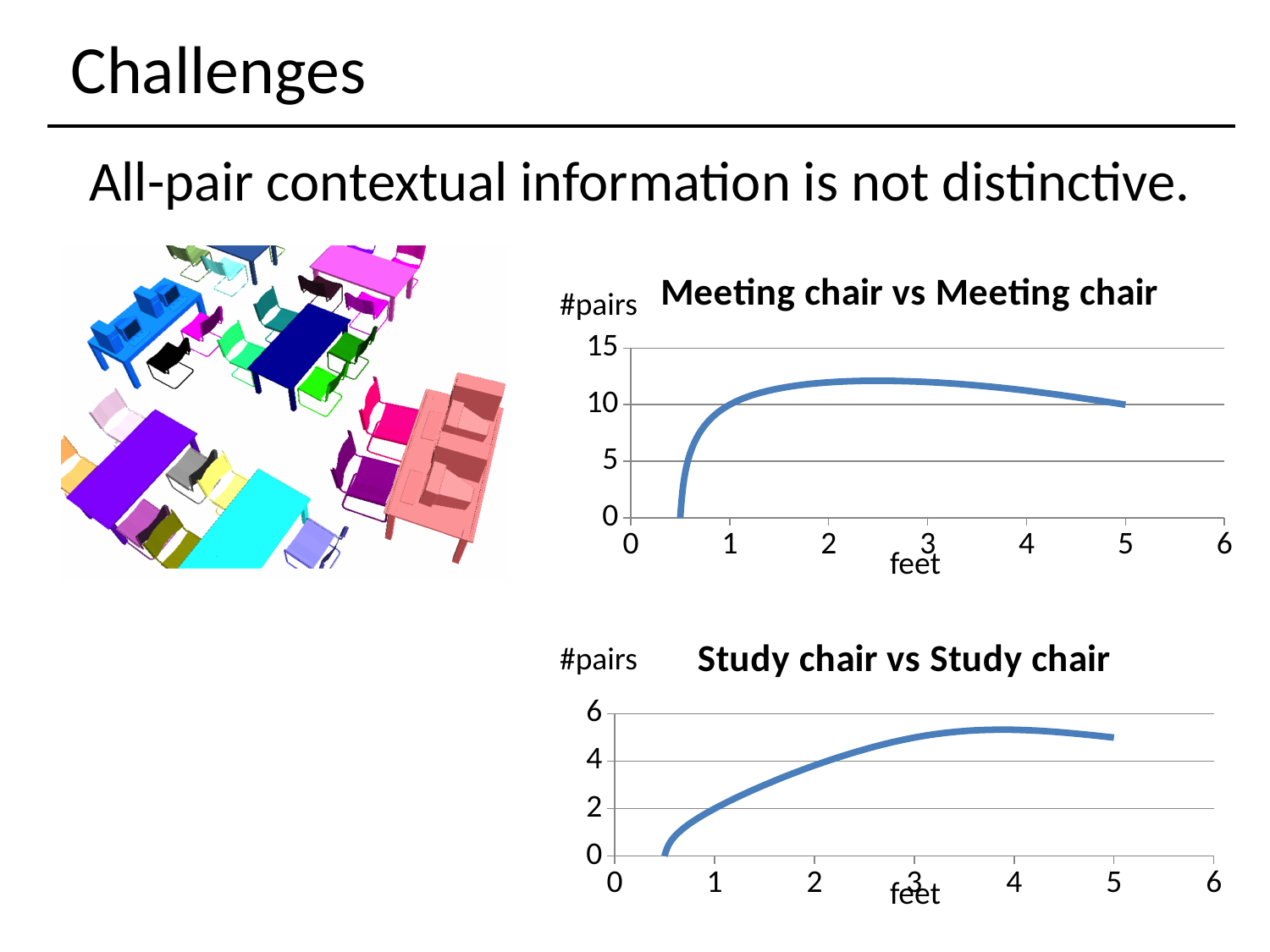
What is the x-axis label on the 'Meeting chair vs Meeting chair' chart? feet In the 'Meeting chair vs Meeting chair' chart, is the value at 1 foot greater or less than 5? greater At 3 feet, which chart shows the larger #pairs value: 'Meeting chair vs Meeting chair' or 'Study chair vs Study chair'? Meeting chair vs Meeting chair In the 'Meeting chair vs Meeting chair' chart, is the value at 3 feet greater or less than 10? greater What kind of chart is the 'Meeting chair vs Meeting chair' chart? line chart In the 'Study chair vs Study chair' chart, is the value at 2 feet greater or less than 2? greater What is the title of the lower chart on the slide? Study chair vs Study chair In the 'Meeting chair vs Meeting chair' chart, what is the value of #pairs at 5 feet? 10 In the 'Study chair vs Study chair' chart, does the curve rise or fall between 1 and 3 feet? rise In the 'Meeting chair vs Meeting chair' chart, does the curve rise or fall between 4 and 5 feet? fall